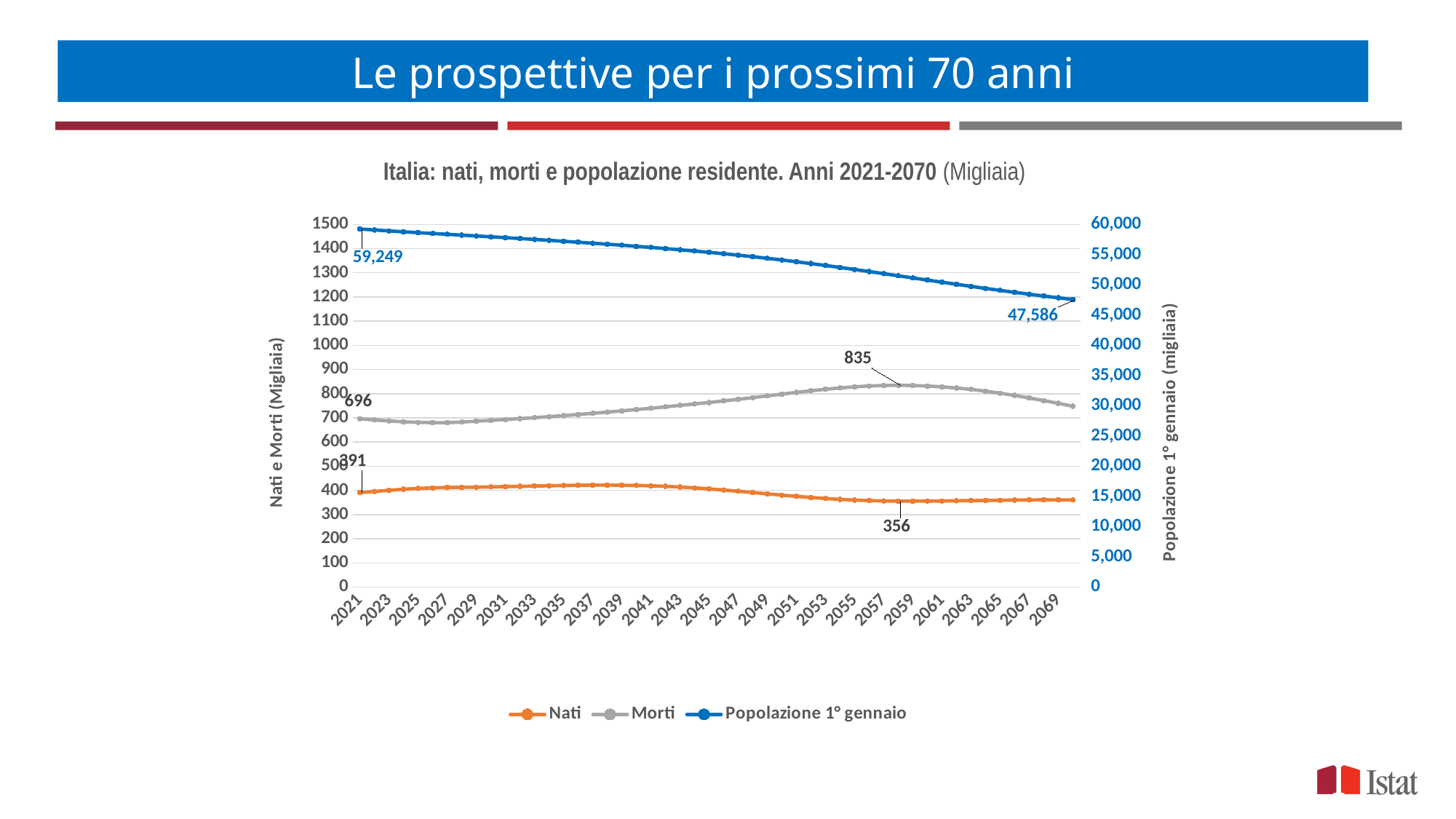
What is the title of the chart? Italia: nati, morti e popolazione residente. Anni 2021-2070 (Migliaia) What is the value of Popolazione 1° gennaio in 2021? 59,249 What is the difference between the Morti peak value (835) and the Morti value in 2021 (696)? 139 By how much does Popolazione 1° gennaio decrease between 2021 and 2070? 11,663 Does the Popolazione 1° gennaio series rise or fall from 2021 to 2070? fall What kind of chart is shown on the slide? line chart What is the value of Morti in 2021? 696 What is the lowest value labelled on the Nati series? 356 Is the value for Nati in 2041 greater or less than 500? less What is the peak value labelled on the Morti series? 835 How many series does the legend list? 3 What is the value of Popolazione 1° gennaio at the end of the series (2070)? 47,586